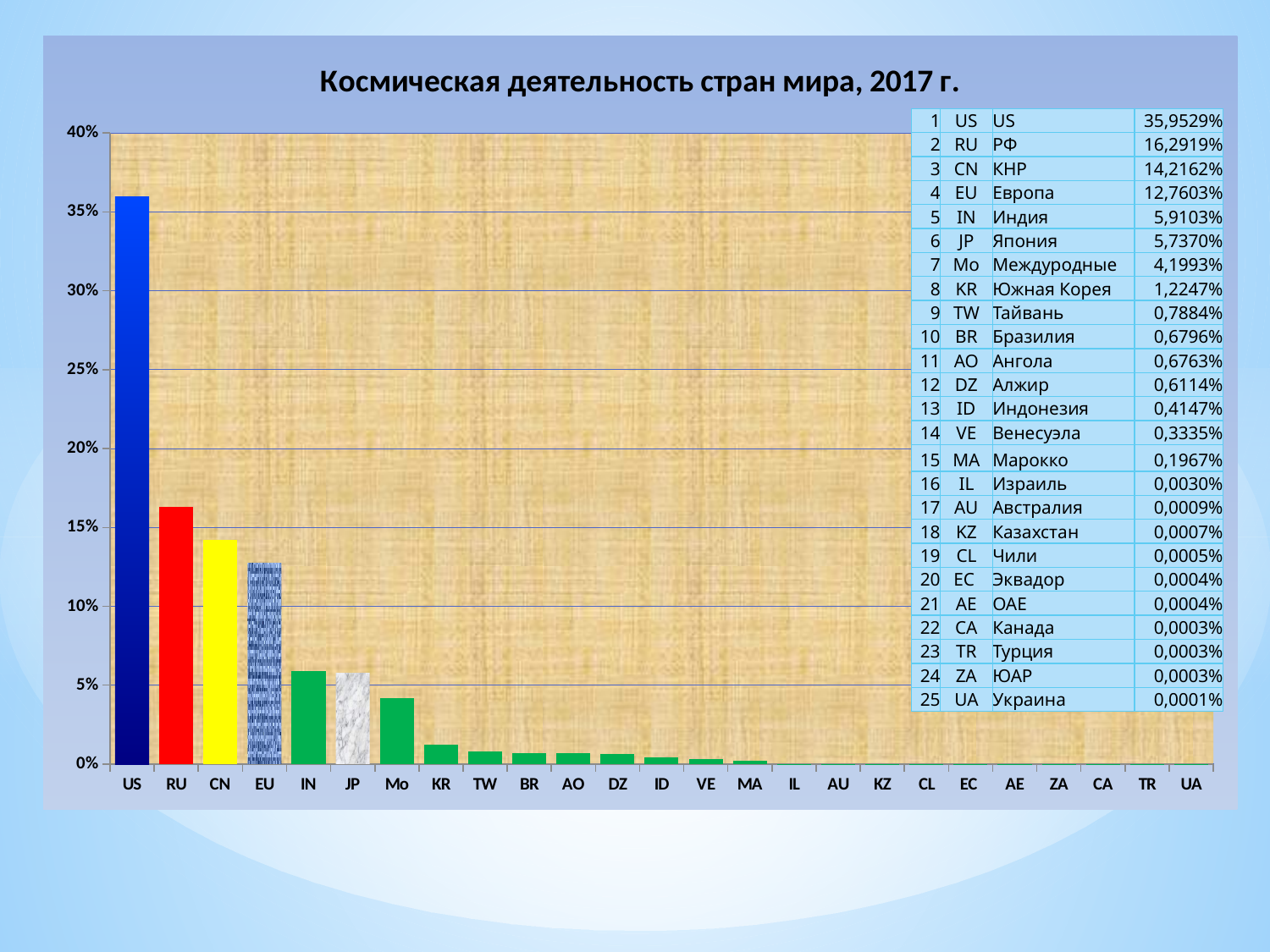
What is the value for JP? 5,7370% What kind of chart is this? bar chart Which is larger, the value for CN or the value for EU? CN Do the values rise or fall from left to right along the x axis? fall What is the difference between the values for US and RU? 19,6610% How many categories are shown on the x axis? 25 Is the value for RU greater or less than 15%? greater Which category has the lowest value? UA What is the value for US? 35,9529% What is the value for RU? 16,2919% What is the value for KR? 1,2247% Which category has the highest value? US